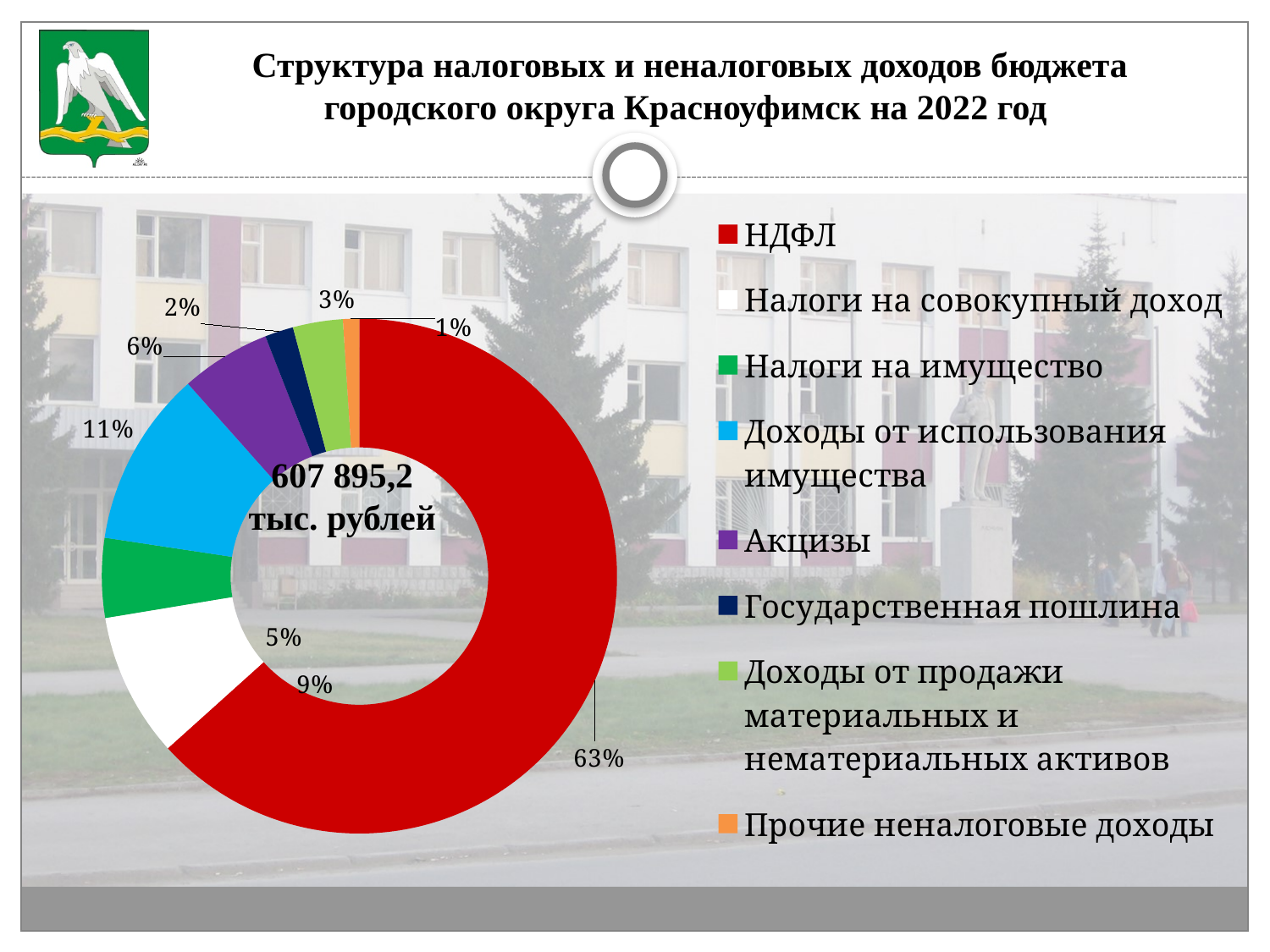
Which category has the largest share of the chart? НДФЛ How many categories does the legend list? 8 What share of the chart does НДФЛ account for? 63% What kind of chart is shown on the slide? Doughnut chart What is the difference between the shares of НДФЛ and Доходы от использования имущества? 52% What is the value shown for Государственная пошлина? 2% Which category has the smallest share of the chart? Прочие неналоговые доходы What is the value shown for Доходы от использования имущества? 11% What is the value shown for Налоги на совокупный доход? 9% What total amount is printed in the centre of the chart? 607 895,2 тыс. рублей Which is larger, the share of Налоги на совокупный доход or the share of Налоги на имущество? Налоги на совокупный доход What is the value shown for Акцизы? 6%